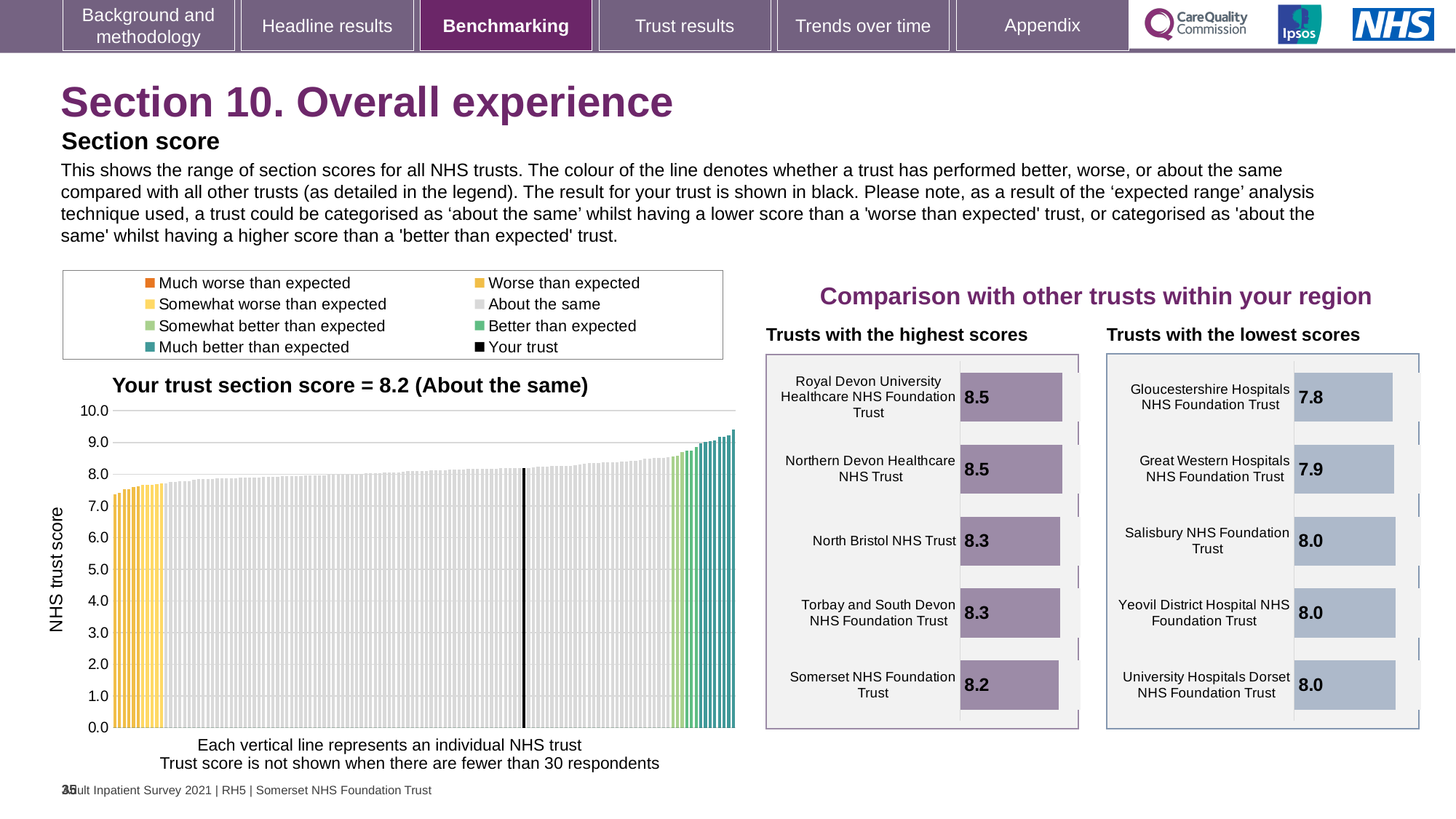
What kind of chart is the 'Your trust section score' chart? bar chart How many trusts are listed in the 'Trusts with the highest scores' chart? 5 In the 'Trusts with the highest scores' chart, what is the score for North Bristol NHS Trust? 8.3 In the 'Trusts with the lowest scores' chart, which trust has the lowest score? Gloucestershire Hospitals NHS Foundation Trust In the 'Trusts with the highest scores' chart, what is the difference between the scores of Royal Devon University Healthcare NHS Foundation Trust and Somerset NHS Foundation Trust? 0.3 In the 'Trusts with the lowest scores' chart, what is the difference between the scores of Great Western Hospitals NHS Foundation Trust and Gloucestershire Hospitals NHS Foundation Trust? 0.1 In the 'Trusts with the highest scores' chart, what is the score for Royal Devon University Healthcare NHS Foundation Trust? 8.5 In the 'Trusts with the highest scores' chart, which trust has the lowest score shown? Somerset NHS Foundation Trust In the 'Trusts with the lowest scores' chart, which has the higher score: Gloucestershire Hospitals NHS Foundation Trust or Salisbury NHS Foundation Trust? Salisbury NHS Foundation Trust In the 'Your trust section score' chart, is the value for your trust greater or less than 8.0? greater In the 'Your trust section score' chart, do the values rise or fall from left to right along the x axis? rise In the 'Trusts with the lowest scores' chart, what is the score for Gloucestershire Hospitals NHS Foundation Trust? 7.8